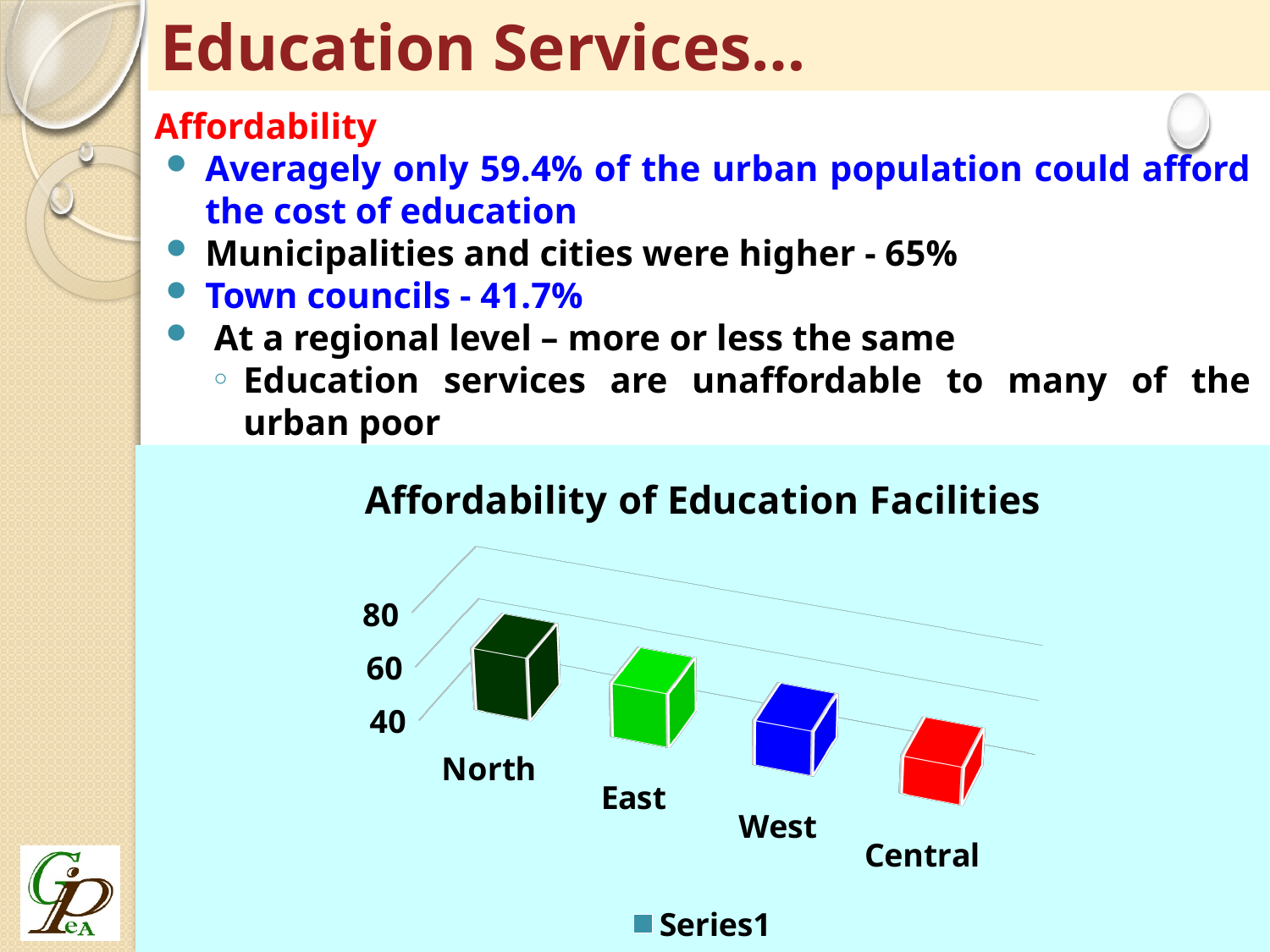
Which category is plotted last (rightmost) on the x axis of the chart? Central Is the value for West greater or less than 80? less What is the name of the series shown in the chart legend? Series1 What is the title of the chart on the slide? Affordability of Education Facilities Which category is plotted first (leftmost) on the x axis of the chart? North Is the value for Central greater or less than 40? greater Is the value for North greater or less than 40? greater How many series does the legend of the "Affordability of Education Facilities" chart list? 1 What kind of chart is shown under the title "Affordability of Education Facilities"? bar chart How many categories are plotted in the "Affordability of Education Facilities" chart? 4